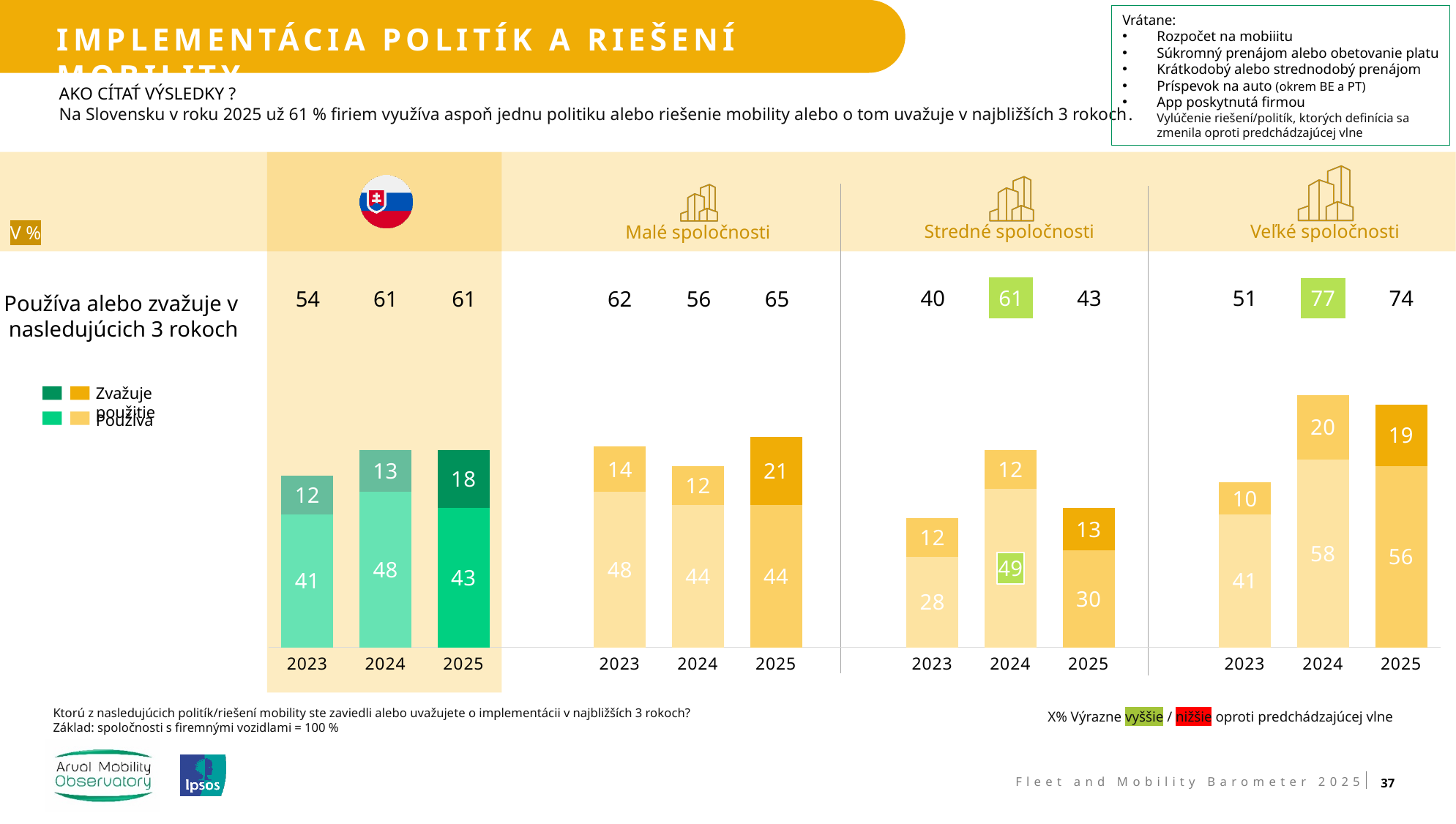
What kind of chart is used for the Veľké spoločnosti data? Stacked bar chart In the Veľké spoločnosti chart, which year has the highest total? 2024 In the Stredné spoločnosti chart, which year has the lowest total? 2023 In the Malé spoločnosti chart, is the 'Zvažuje použitie' value larger in 2025 or in 2024? 2025 How many series does the legend list? 2 In the Veľké spoločnosti chart, what is the difference between the 'Používa' values for 2024 and 2023? 17 In the Slovakia (flag) chart, what is the 'Používa' value for 2025? 43 How many years are shown on the x axis of the Malé spoločnosti chart? 3 In the Slovakia (flag) chart, what is the 'Zvažuje použitie' value for 2024? 13 In the Stredné spoločnosti chart, what is the total of the stacked bar for 2024? 61 In the Stredné spoločnosti chart, what is the 'Používa' value for 2023? 28 In the Malé spoločnosti chart, what is the total shown above the 2025 bar? 65